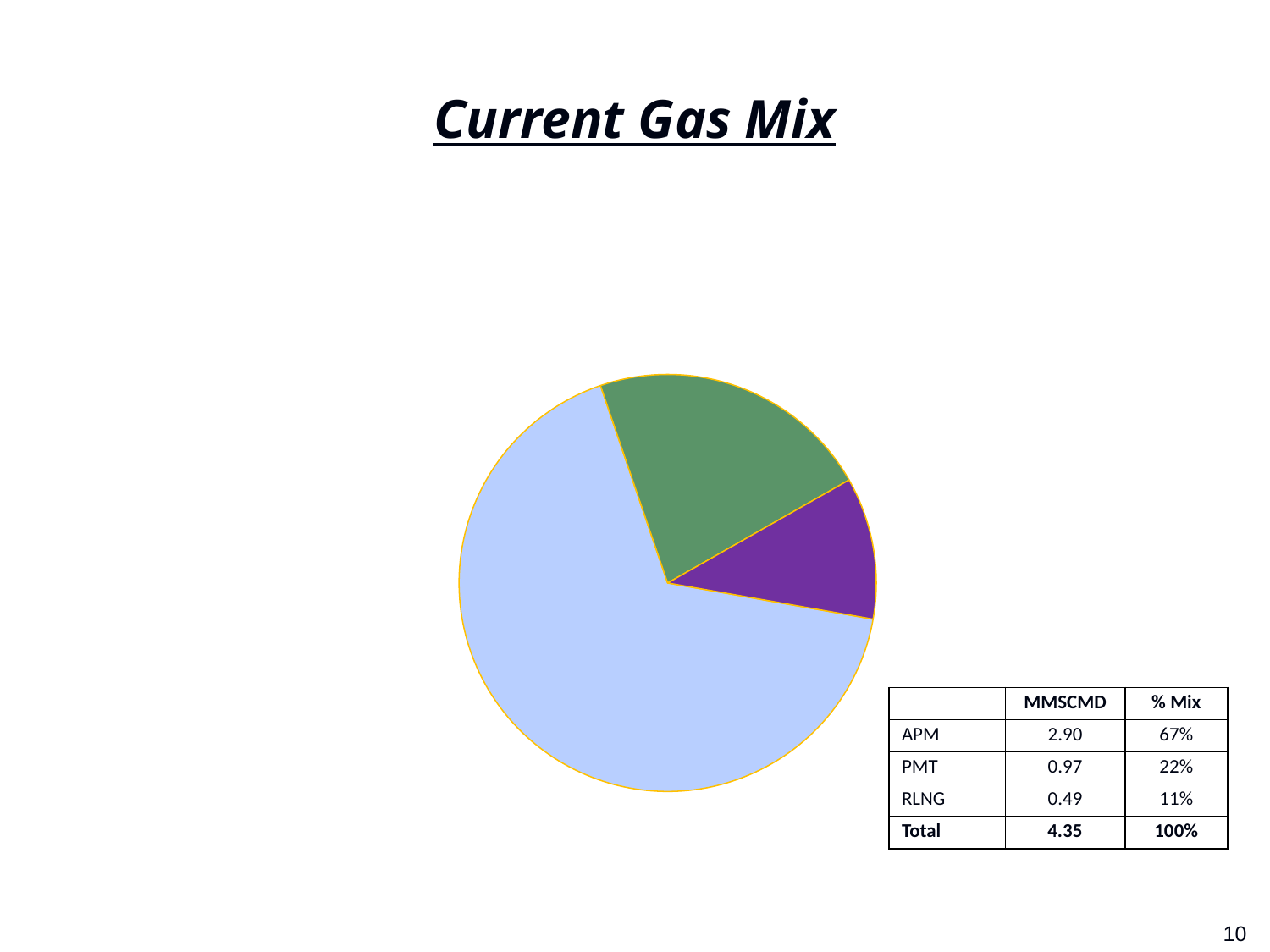
What share of the gas mix does RLNG account for? 11% What is the total MMSCMD across all three gas sources? 4.35 Which gas source has the smallest share of the mix? RLNG Which gas source has the largest share of the mix? APM What is the MMSCMD value for PMT? 0.97 How many slices does the pie chart have? 3 What is the MMSCMD value for RLNG? 0.49 Which colour is the largest slice of the pie chart? light blue What is the MMSCMD value for APM in the table beside the pie chart? 2.90 What share of the gas mix does APM account for? 67% What is the difference in MMSCMD between APM and PMT? 1.93 What kind of chart is shown on the slide? pie chart